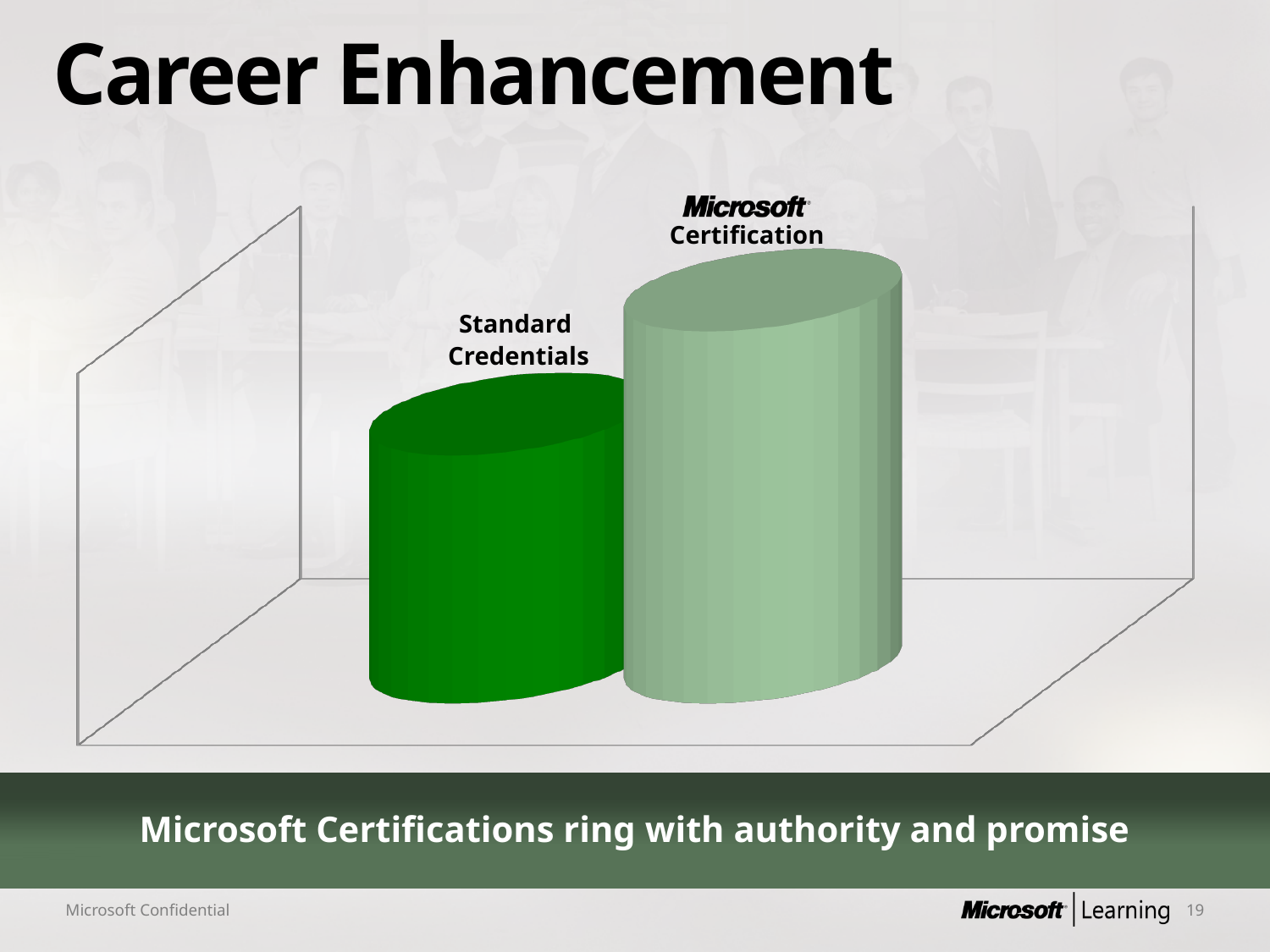
Which bar is taller: Standard Credentials or Microsoft Certification? Microsoft Certification What is the title of the slide containing the chart? Career Enhancement How many bars are plotted in the chart? 2 What colour is the Standard Credentials bar in the chart? dark green Is the bar for Standard Credentials taller or shorter than the bar for Microsoft Certification? shorter Which category has the shortest bar in the chart? Standard Credentials What kind of chart is shown on the slide? bar chart Which category has the tallest bar in the chart? Microsoft Certification